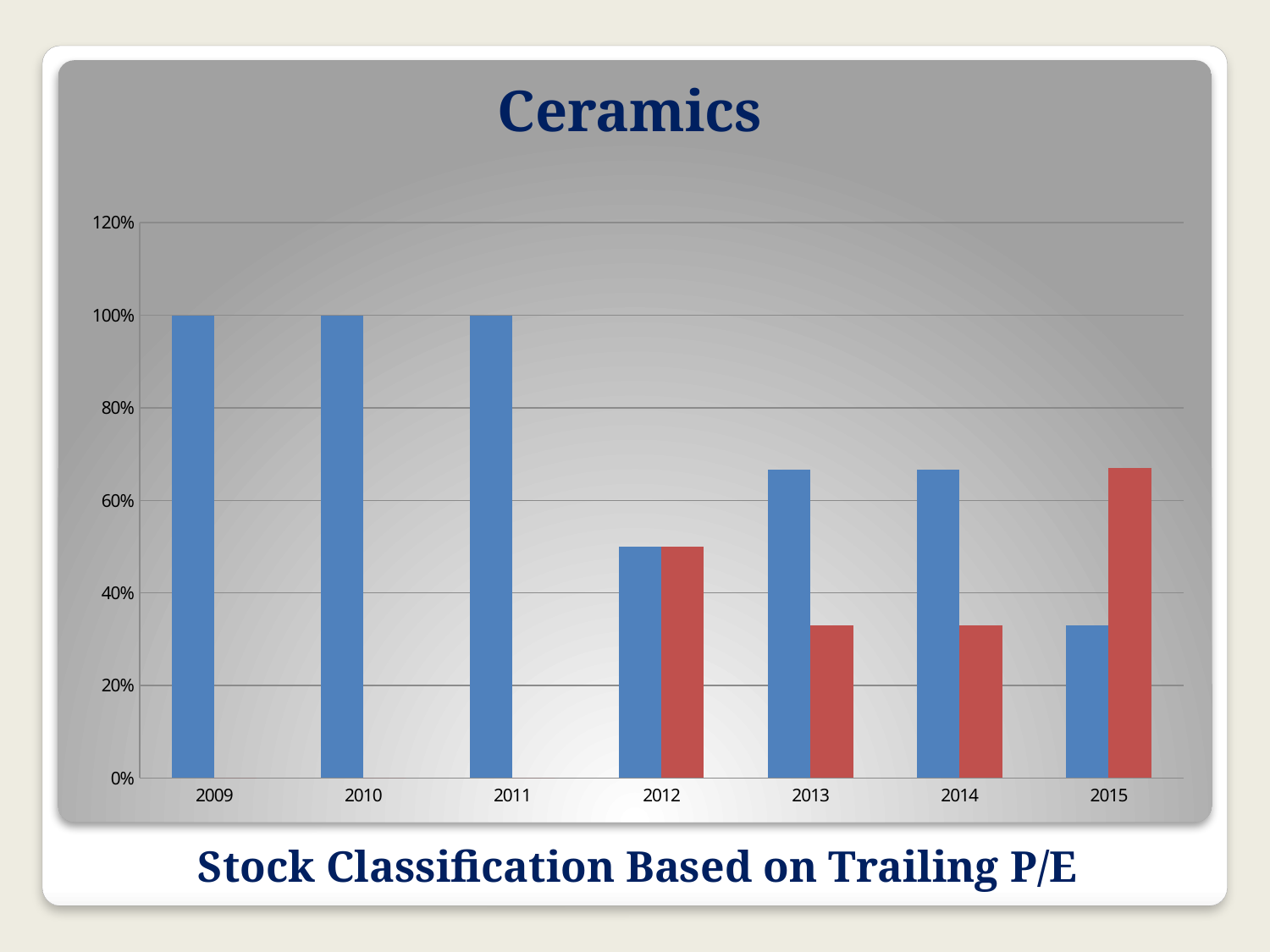
What is the value of the blue bar for 2011? 100% What is the title of the chart? Ceramics Which year has the lowest blue bar? 2015 Is the value of the red bar for 2015 greater or less than 60%? greater In 2015, which bar is larger, the blue bar or the red bar? the red bar In 2013, which bar is larger, the blue bar or the red bar? the blue bar Is the value of the red bar for 2014 greater or less than 40%? less Is the value of the blue bar for 2013 greater or less than 60%? greater How many years are shown on the x axis of the chart? 7 What is the value of the blue bar for 2009? 100% What type of chart is shown on the slide? bar chart